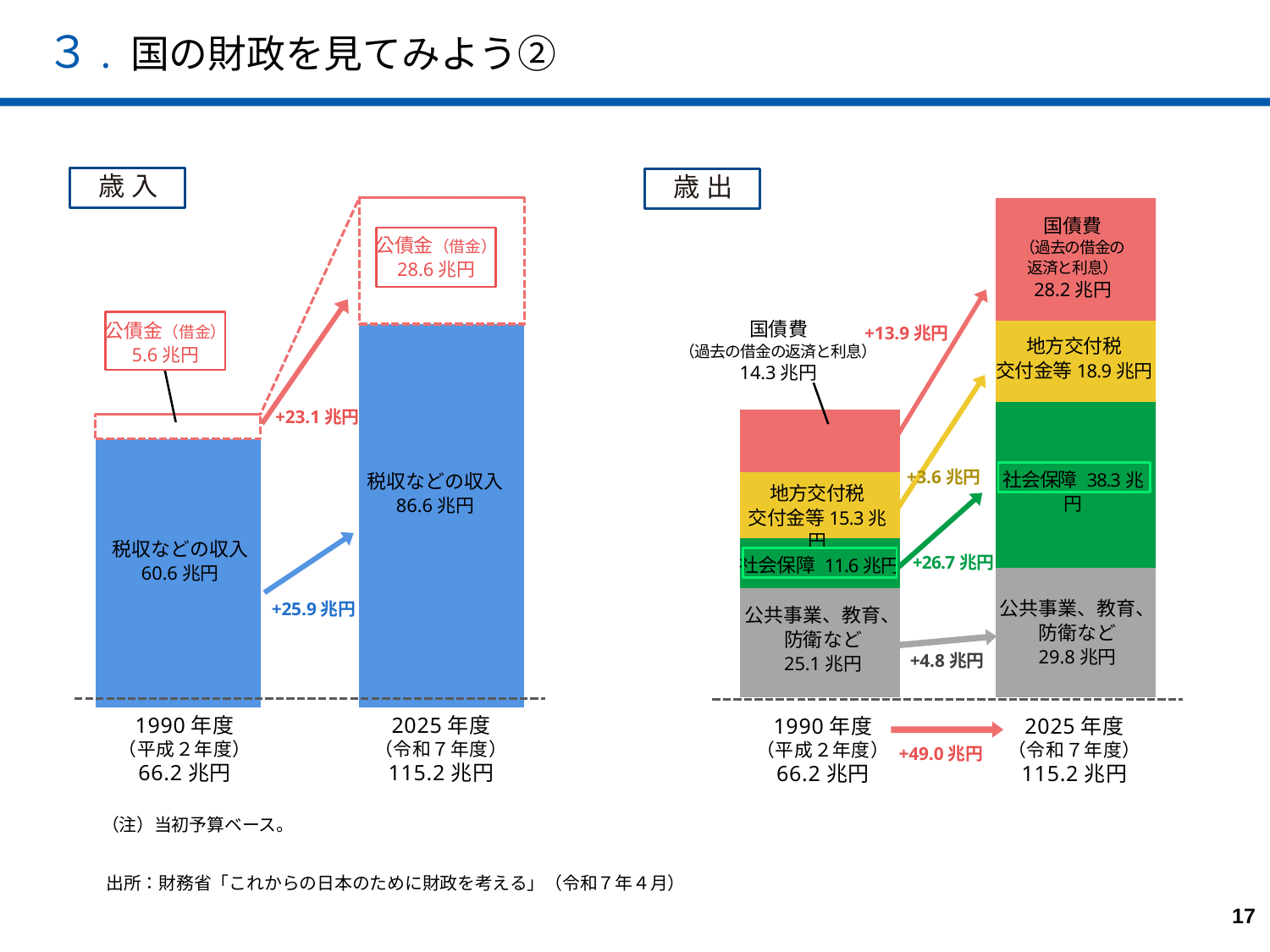
歳出のグラフで、2025年度の「国債費」と「地方交付税交付金等」ではどちらが大きいですか？ 国債費 歳出のグラフで、1990年度に最も小さい項目はどれですか？ 社会保障 歳入のグラフはどのような種類のグラフですか？ 積み上げ棒グラフ 歳出のグラフで、社会保障は1990年度から2025年度にかけていくら増えましたか？ +26.7兆円 歳出のグラフで、2025年度に最も大きい項目はどれですか？ 社会保障 歳出のグラフで、2025年度の「社会保障」はいくらですか？ 38.3兆円 歳入のグラフで、1990年度の「公債金（借金）」はいくらですか？ 5.6兆円 歳入のグラフで、2025年度の「税収などの収入」はいくらですか？ 86.6兆円 歳入のグラフで、公債金（借金）は1990年度から2025年度にかけていくら増えましたか？ +23.1兆円 歳入のグラフで、2025年度の歳入の合計はいくらですか？ 115.2兆円 歳出のグラフで、各年度の棒はいくつの項目に分かれていますか？ 4 歳出のグラフで、歳出の合計は1990年度から2025年度にかけていくら増えましたか？ +49.0兆円